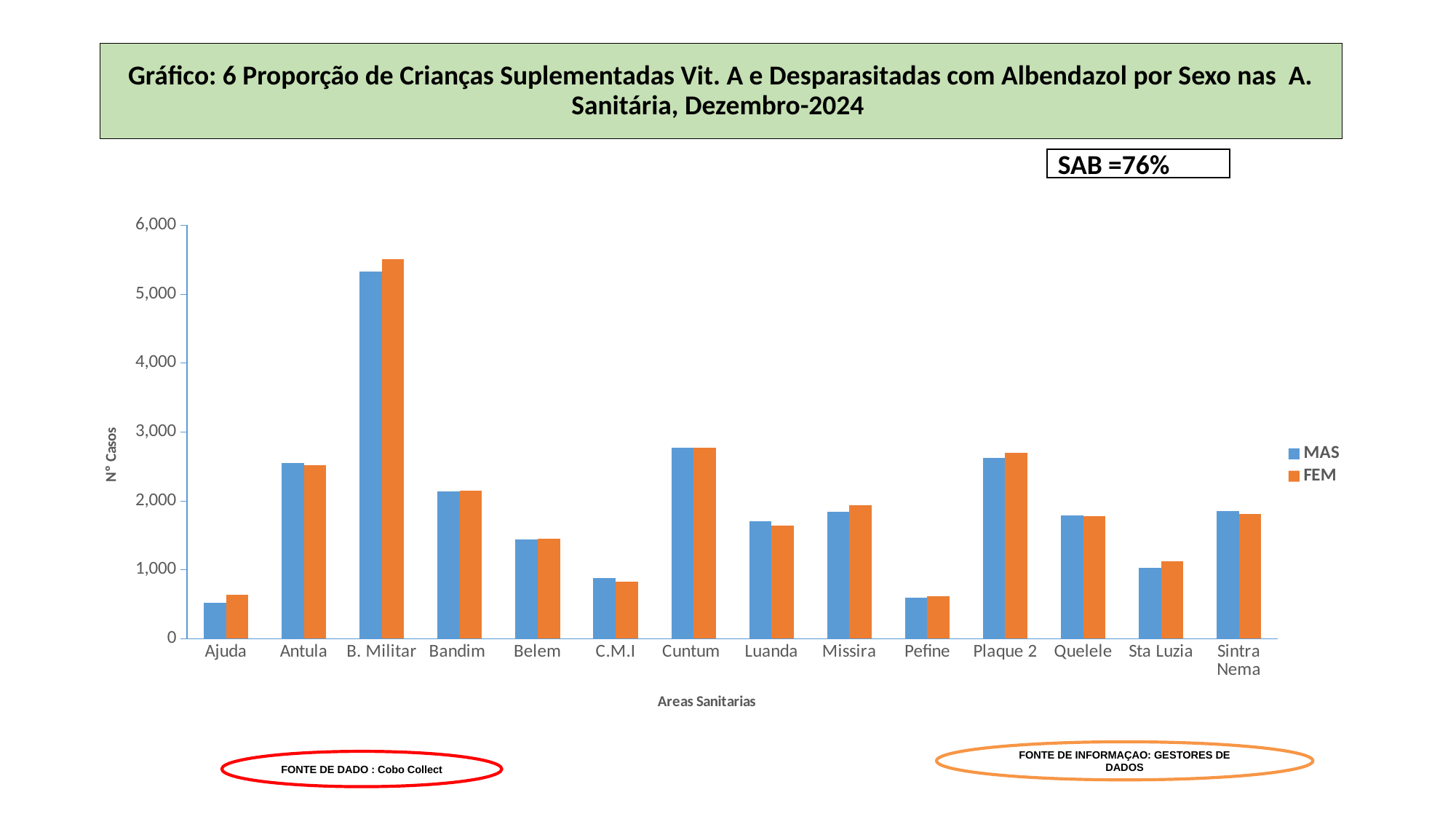
Which area has the highest MAS value? B. Militar Is the MAS value for B. Militar greater or less than 5,000? greater What is the title of the y axis? N° Casos Is the MAS value for Ajuda greater or less than 1,000? less Is the FEM value for Antula greater or less than 2,000? greater How many series does the legend list? 2 How many areas sanitárias (categories) are shown on the x axis? 14 Which area has the highest FEM value? B. Militar Which is larger, the MAS value for Antula or the MAS value for Bandim? Antula What kind of chart is shown on the slide? bar chart